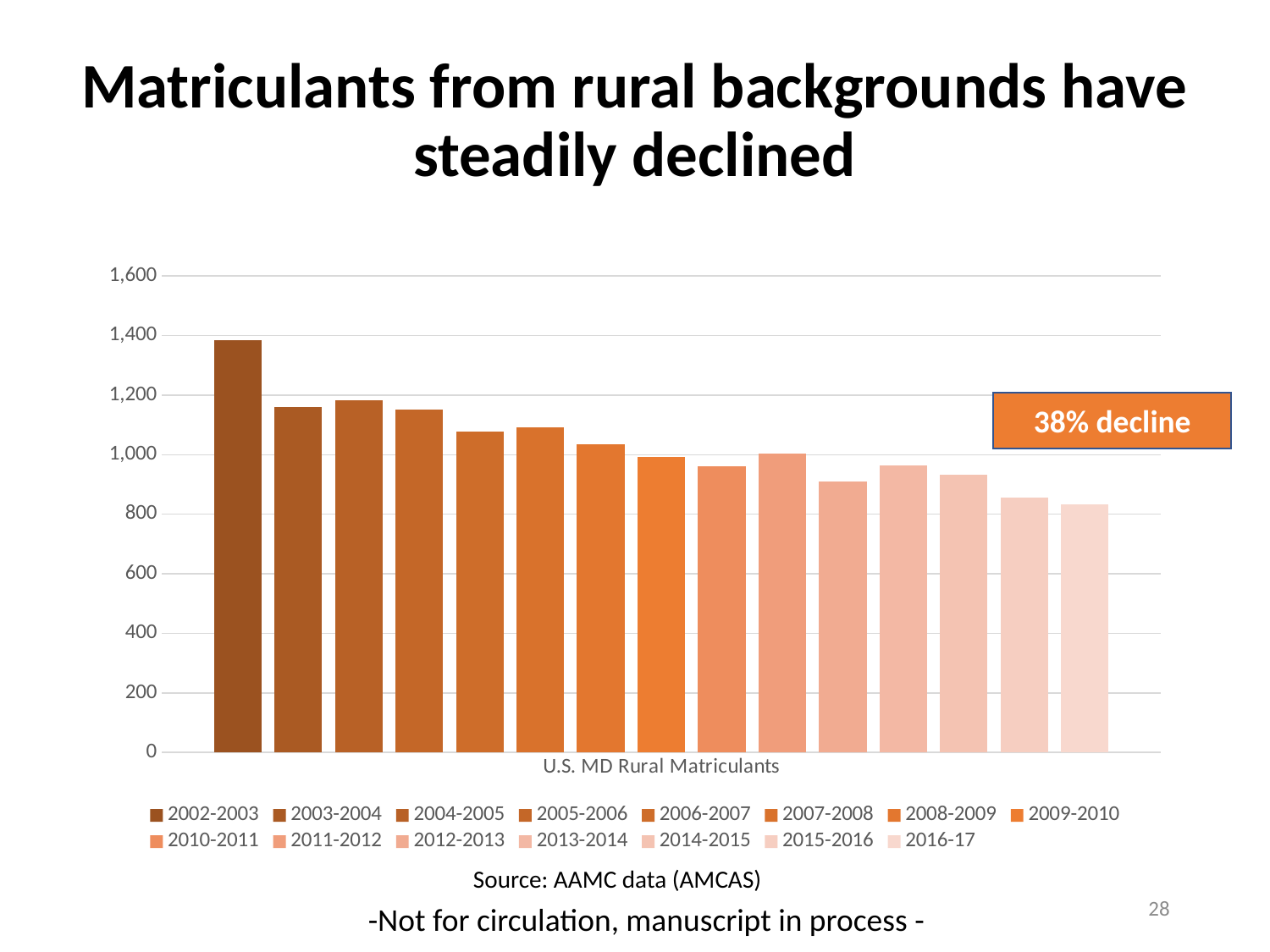
How many series does the legend list? 15 Which year has the lowest number of U.S. MD rural matriculants? 2016-17 What kind of chart is shown on the slide? bar chart Is the value for 2002-2003 greater or less than 1,200? greater How many bars are plotted in the chart? 15 Is the value for 2016-17 greater or less than 1,000? less Which year has the highest number of U.S. MD rural matriculants? 2002-2003 What percentage decline does the annotation box on the chart state? 38% decline Is the value for 2005-2006 greater or less than 1,000? greater Which is larger, the value for 2002-2003 or the value for 2015-2016? 2002-2003 Do the values generally rise or fall from 2002-2003 to 2016-17? fall